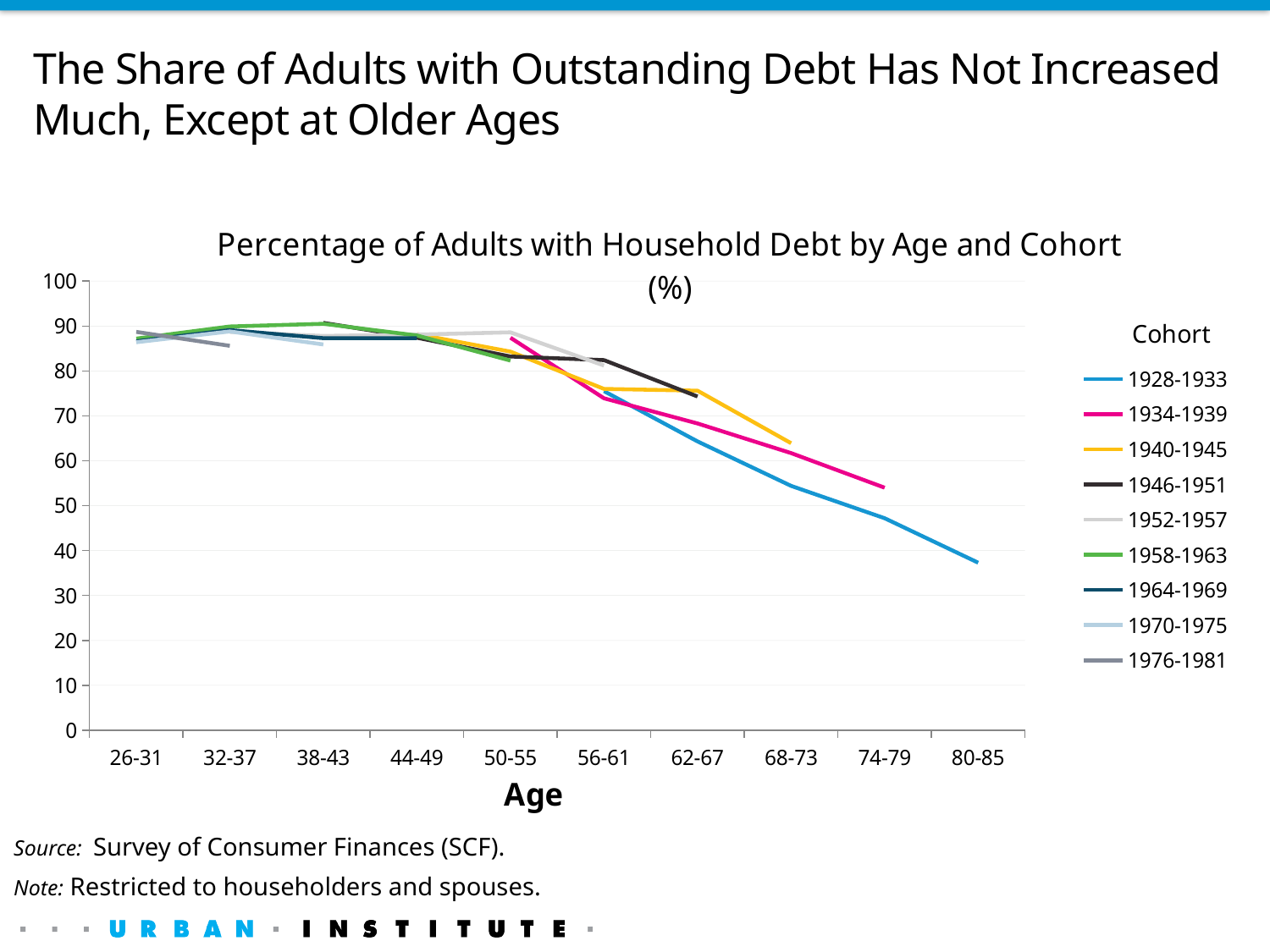
What kind of chart is shown on the slide? line chart How many age groups are shown on the x axis? 10 Is the value for the 1934-1939 cohort at age 74-79 greater or less than 50? greater Is the value for the 1940-1945 cohort at age 68-73 greater or less than 60? greater Is the value for the 1946-1951 cohort at age 62-67 greater or less than 80? less Does the 1928-1933 cohort line rise or fall from age 56-61 to age 80-85? fall How many cohorts does the legend list? 9 Which cohort reaches the lowest value anywhere on the chart? 1928-1933 What is the title of the chart? Percentage of Adults with Household Debt by Age and Cohort (%) At age 74-79, which cohort has the higher value, 1928-1933 or 1934-1939? 1934-1939